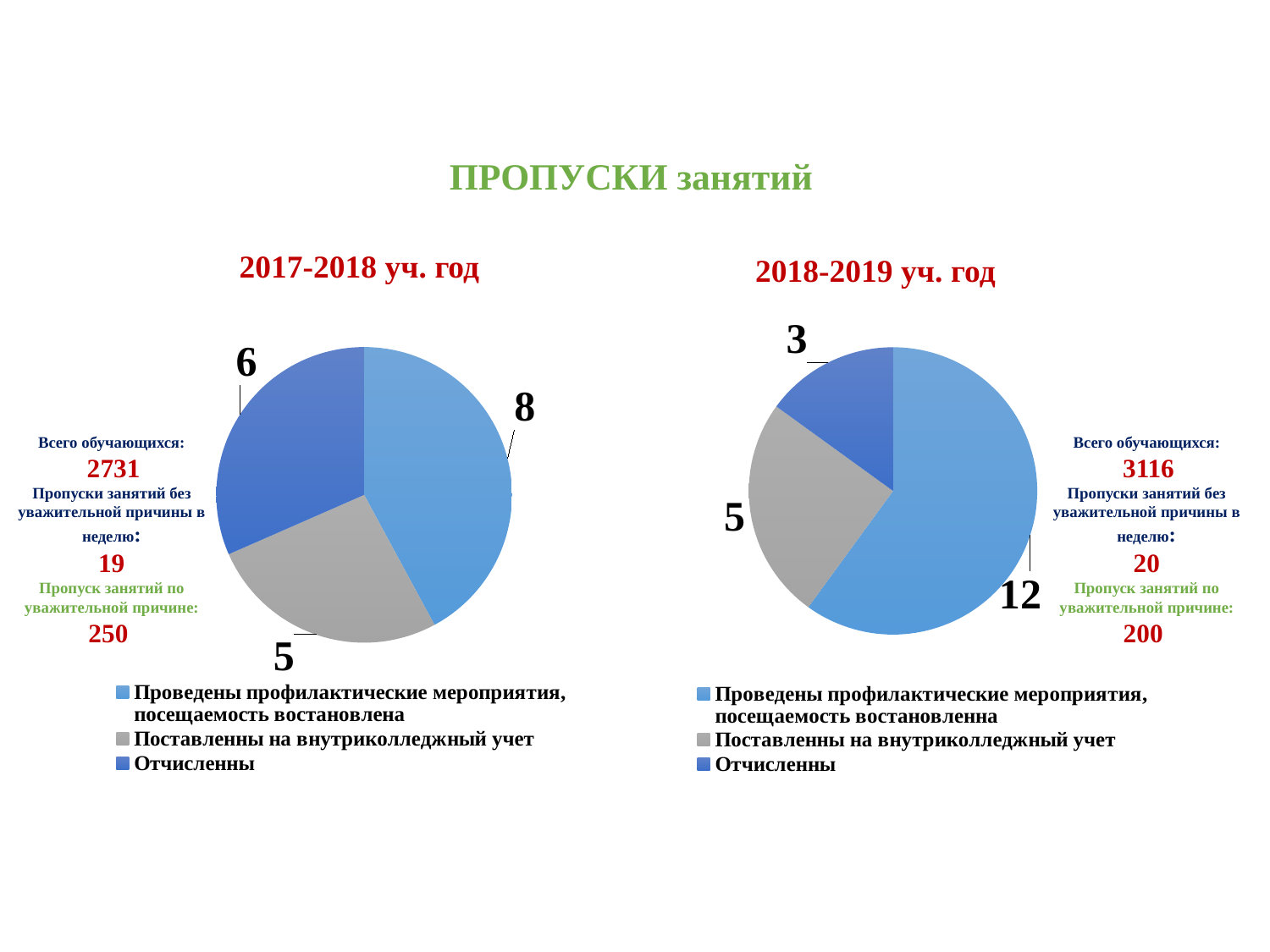
In the 2018-2019 уч. год chart, what is the value for Отчисленны? 3 In the 2018-2019 уч. год chart, what is the difference between the values for Проведены профилактические мероприятия and Отчисленны? 9 In the 2018-2019 уч. год chart, what share of the pie does Отчисленны represent? 15% In the 2018-2019 уч. год chart, which category has the largest slice? Проведены профилактические мероприятия, посещаемость востановленна How many slices does the 2018-2019 уч. год pie chart have? 3 In the 2018-2019 уч. год chart, what is the value for Поставленны на внутриколледжный учет? 5 What type of chart is used for the 2017-2018 уч. год data? pie chart Which is larger in the 2017-2018 уч. год chart: Отчисленны or Поставленны на внутриколледжный учет? Отчисленны In the 2017-2018 уч. год chart, what is the value for Отчисленны? 6 How many entries does the legend of the 2017-2018 уч. год chart list? 3 In the 2017-2018 уч. год chart, what is the value for Проведены профилактические мероприятия, посещаемость востановлена? 8 In the 2017-2018 уч. год chart, which category has the smallest slice? Поставленны на внутриколледжный учет